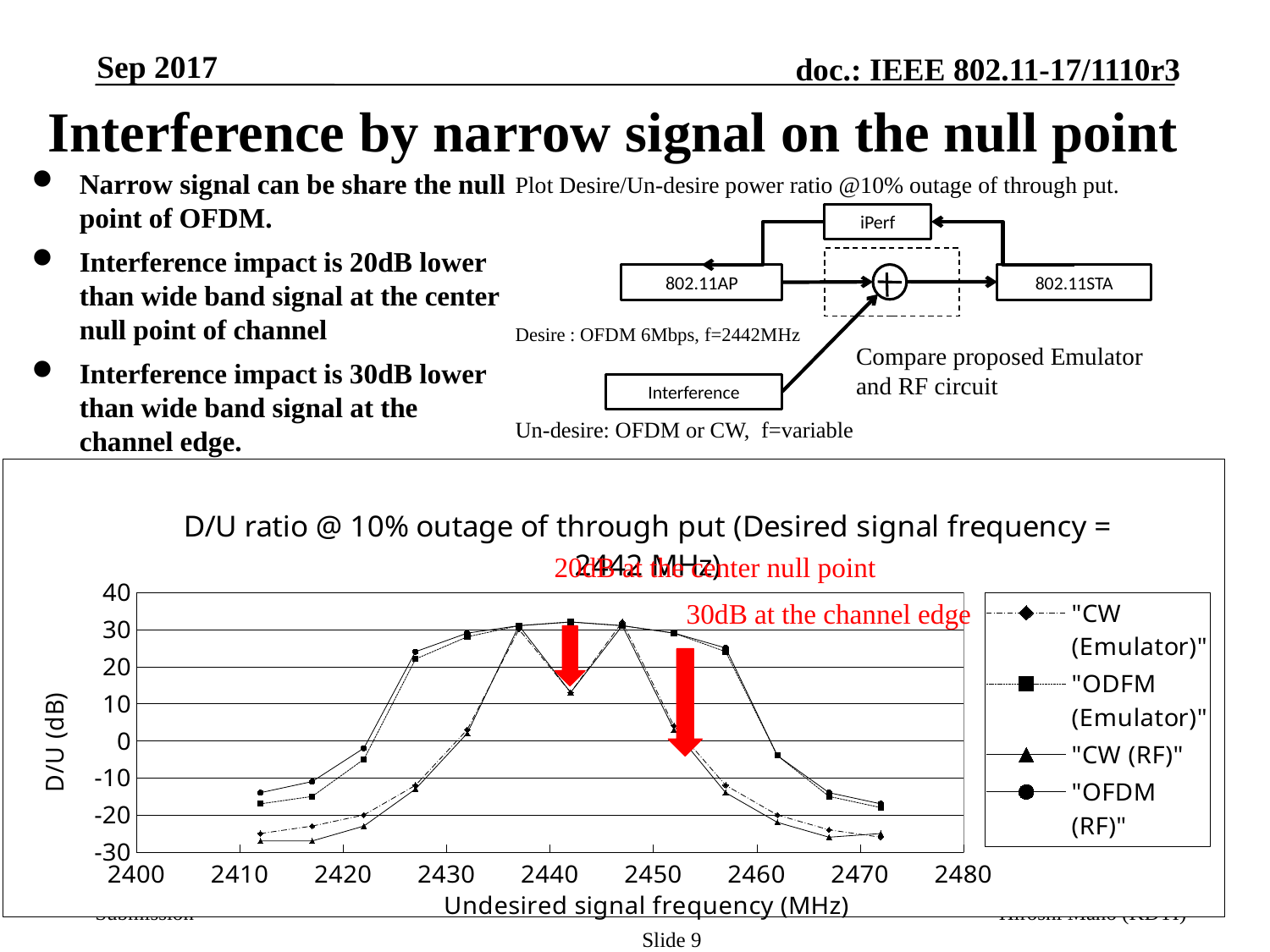
Is the value of the "OFDM (RF)" series at 2412 MHz greater or less than -20? greater What kind of chart is shown on the slide? line chart Is the value of the "CW (Emulator)" series at 2442 MHz greater or less than 20? less Is the value of the "OFDM (RF)" series at 2442 MHz greater or less than 20? greater What is the title of the chart's x axis? Undesired signal frequency (MHz) At 2442 MHz, which is larger: the "OFDM (RF)" value or the "CW (RF)" value? OFDM (RF) How many series does the chart legend list? 4 Do the values of the "CW (RF)" series rise or fall between 2422 MHz and 2437 MHz? rise At 2452 MHz, which is larger: the "ODFM (Emulator)" value or the "CW (Emulator)" value? ODFM (Emulator) What is the title of the chart's y axis? D/U (dB)